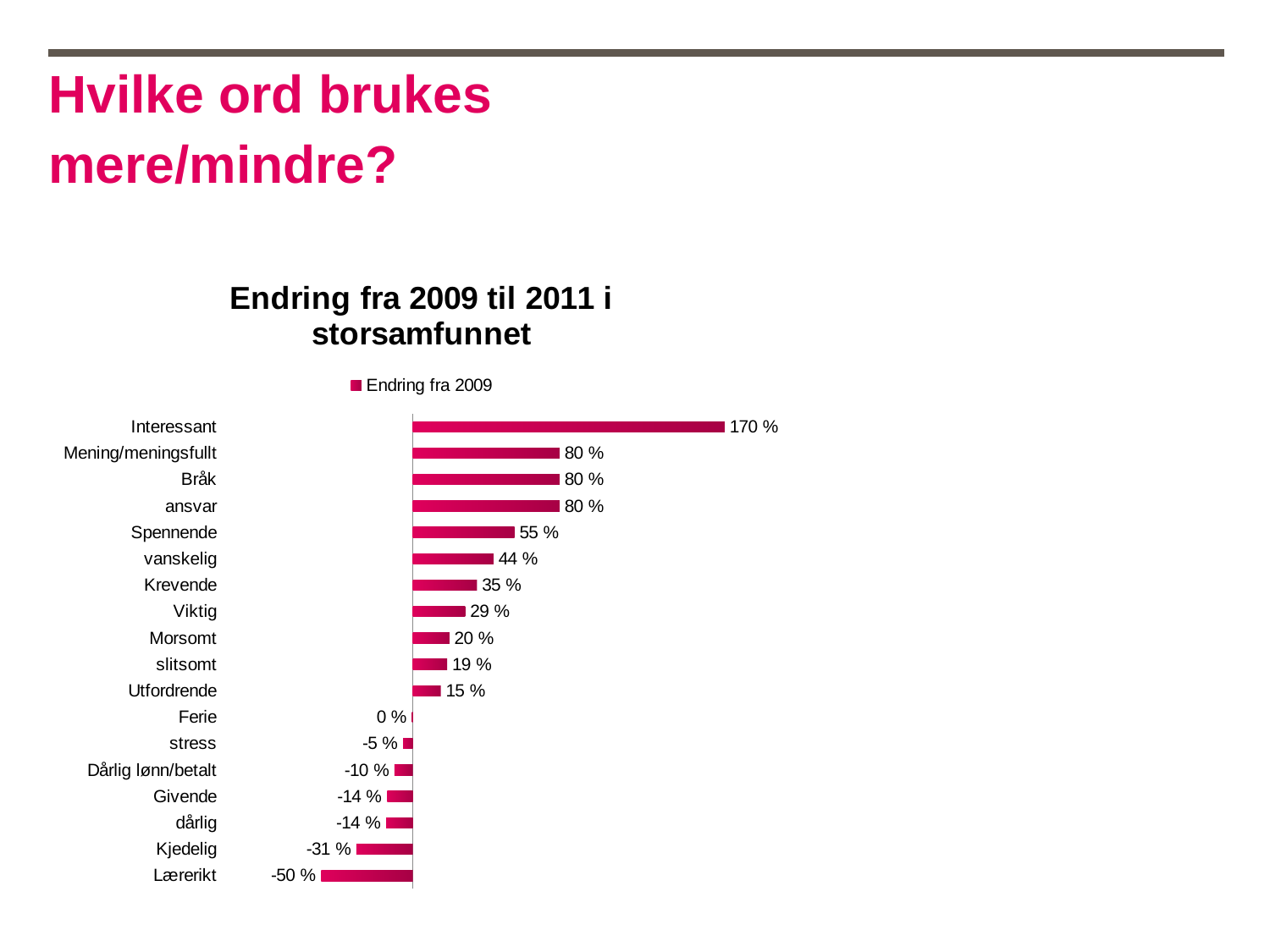
How many categories are shown in the chart? 18 Which category has the highest value? Interessant What is the value for Interessant? 170 % What kind of chart is shown on the slide? Bar chart Which is larger, the value for Krevende or the value for Viktig? Krevende How many series does the legend list? 1 Which category has the lowest value? Lærerikt What is the value for Spennende? 55 % What is the title of the chart? Endring fra 2009 til 2011 i storsamfunnet What is the difference between the values for Interessant and Spennende? 115 % What is the value for Lærerikt? -50 % What is the value for Kjedelig? -31 %